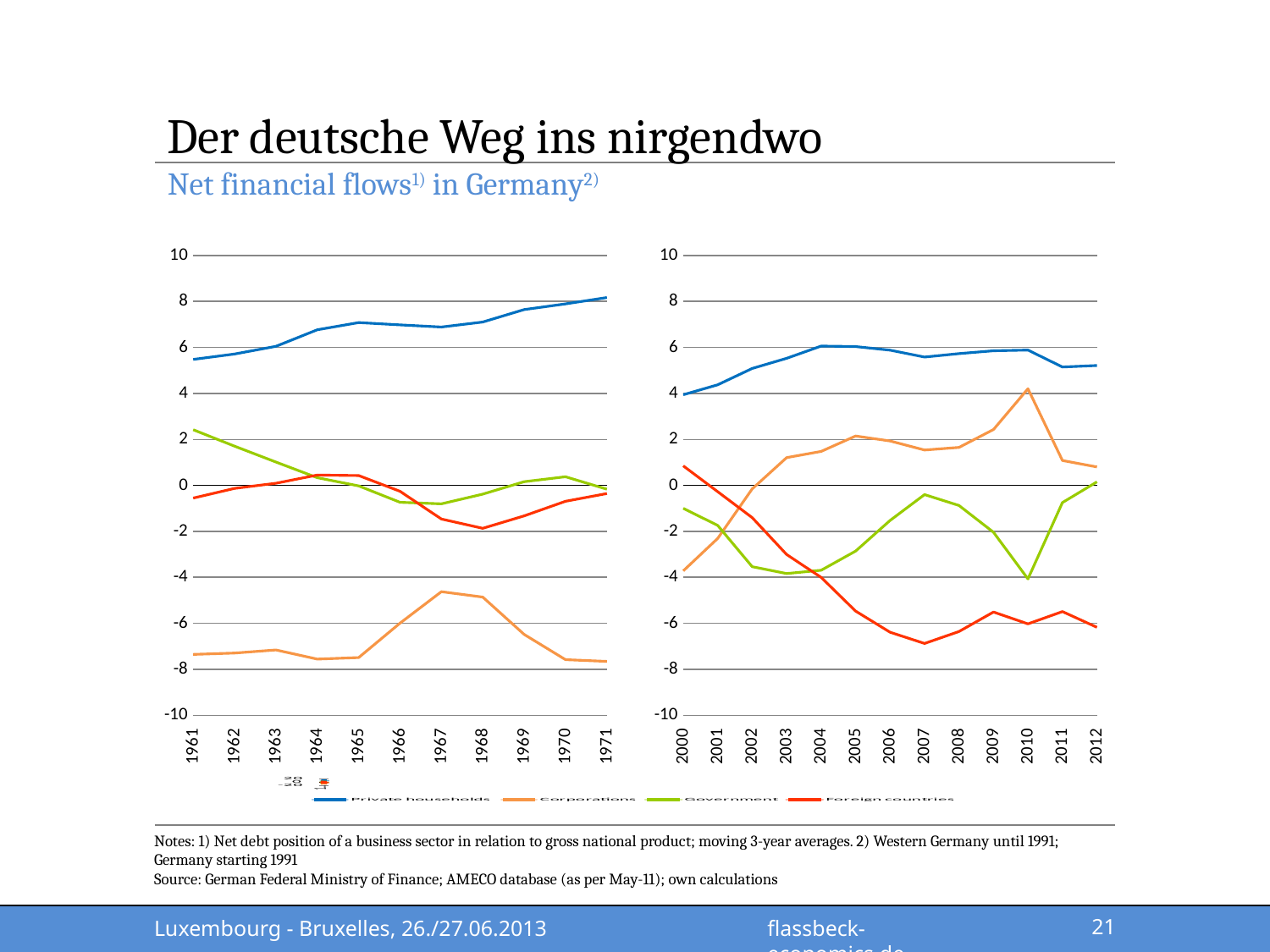
In the left chart (1961–1971), which series has the lowest value in 1961? Corporations In the right chart (2000–2012), is the value for Corporations in 2010 greater or less than 2? greater In the right chart (2000–2012), is the value for Foreign countries in 2007 greater or less than -4? less In the right chart (2000–2012), does the Foreign countries line rise or fall from 2000 to 2012? fall In the right chart (2000–2012), which series has the highest value in 2004? Private households In the left chart (1961–1971), how many years are shown on the x axis? 11 How many series does the legend list? 4 In the left chart (1961–1971), does the Private households line rise or fall from 1961 to 1971? rise In the right chart (2000–2012), which is larger in 2012: Private households or Foreign countries? Private households In the left chart (1961–1971), is the value for Corporations in 1961 greater or less than -6? less What kind of chart is the left chart (1961–1971)? line chart In the right chart (2000–2012), how many years are shown on the x axis? 13